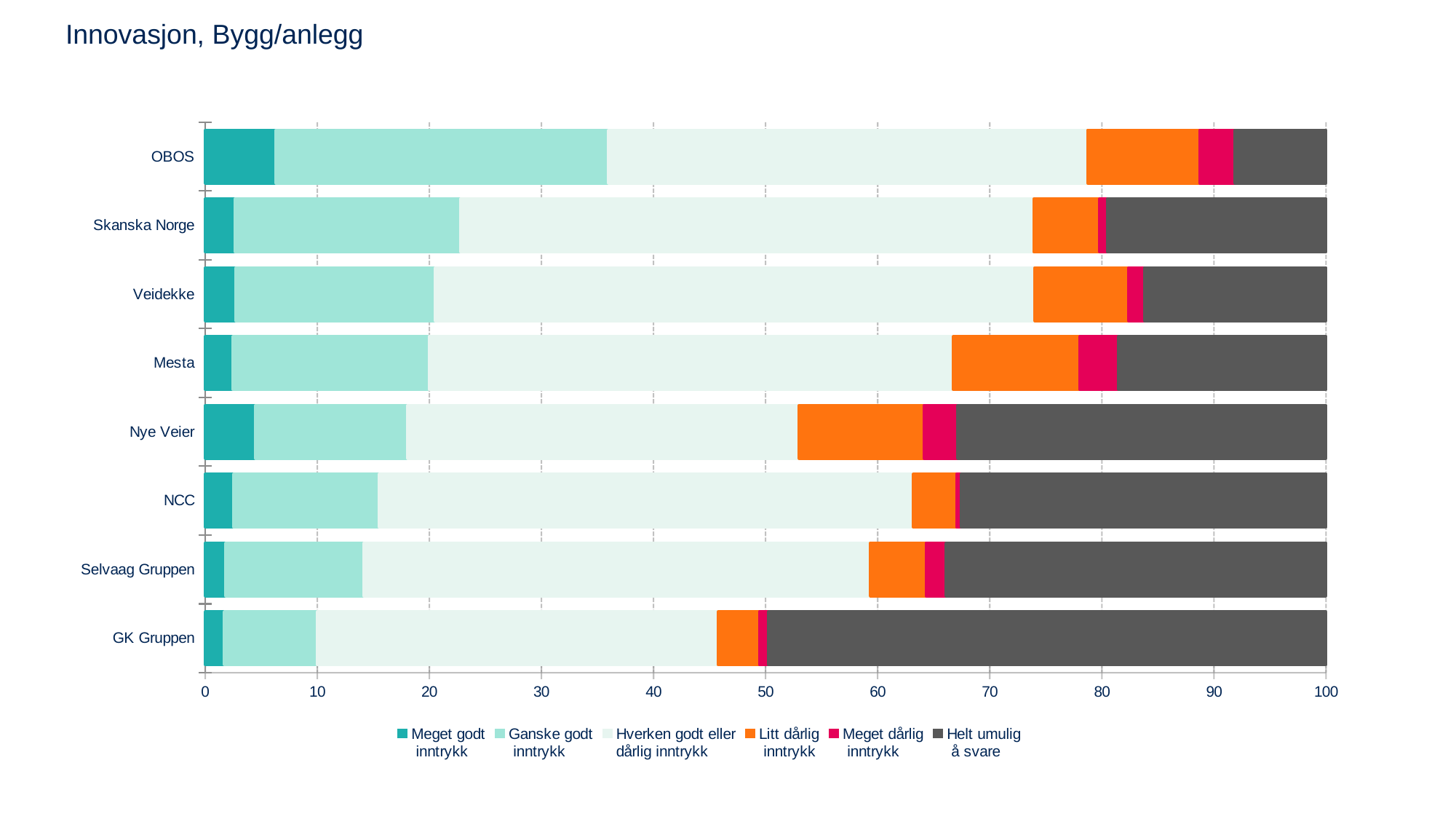
Is the 'Litt dårlig inntrykk' segment larger for Nye Veier or for NCC? Nye Veier Which legend entry is shown in dark grey? Helt umulig å svare Which company has the largest 'Meget godt inntrykk' segment? OBOS What is the title of the chart? Innovasjon, Bygg/anlegg Which company has the smallest 'Ganske godt inntrykk' segment? GK Gruppen What kind of chart is shown on the slide? Stacked bar chart How many series does the legend list? 6 Which company has the largest 'Ganske godt inntrykk' segment? OBOS Is the 'Helt umulig å svare' value for Nye Veier greater or less than 30? greater How many companies are shown on the chart? 8 Is the 'Meget godt inntrykk' value for OBOS greater or less than 10? less Which company has the largest 'Helt umulig å svare' segment? GK Gruppen